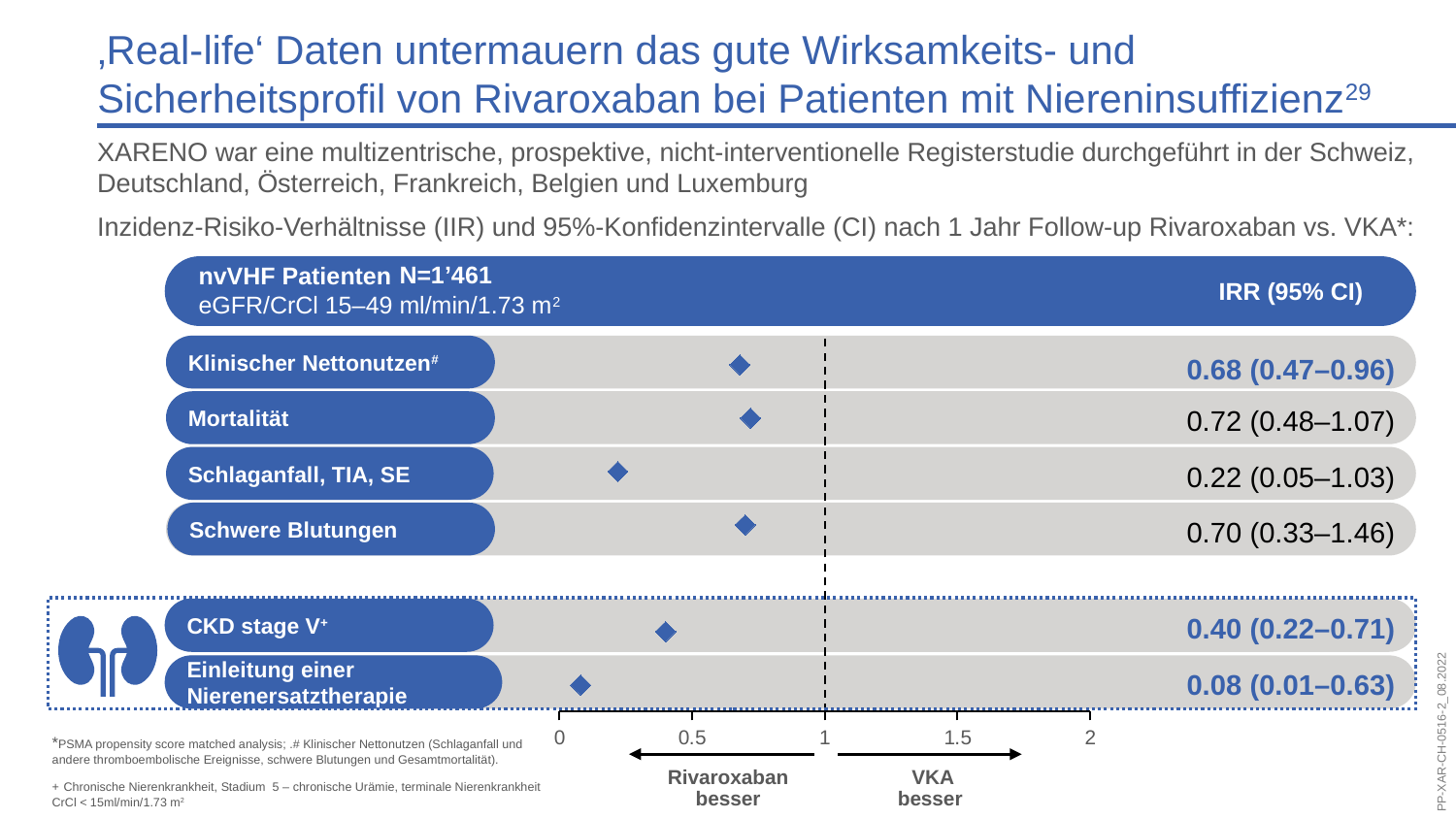
What is the difference between the IRR point estimates for Schwere Blutungen and Schlaganfall, TIA, SE? 0.48 Is the IRR point estimate for CKD stage V greater or less than 1? less What is the IRR point estimate for Schlaganfall, TIA, SE? 0.22 What kind of chart is shown on the slide? Forest plot Which has the larger IRR point estimate, Klinischer Nettonutzen or Schwere Blutungen? Schwere Blutungen What is the IRR (95% CI) shown for Mortalität? 0.72 (0.48–1.07) Which outcome has the highest IRR point estimate? Mortalität How many outcomes are plotted in the chart? 6 What is the IRR (95% CI) shown for CKD stage V? 0.40 (0.22–0.71) What is the IRR (95% CI) shown for Einleitung einer Nierenersatztherapie? 0.08 (0.01–0.63) Which outcome has the lowest IRR point estimate? Einleitung einer Nierenersatztherapie According to the axis labels, which treatment is favoured by values to the left of the dashed line at 1? Rivaroxaban